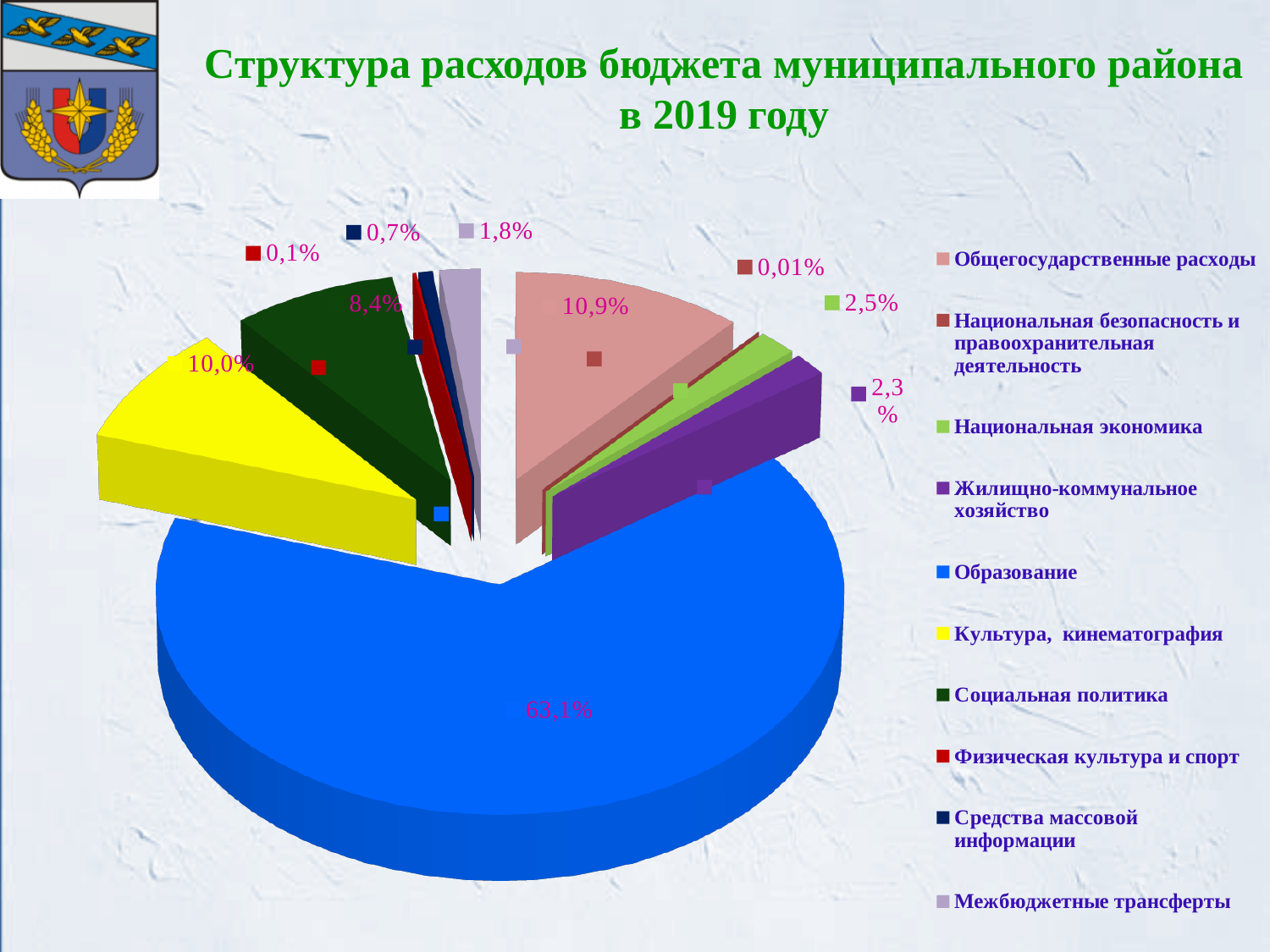
What is the value shown for Культура, кинематография? 10,0% What type of chart is shown on the slide? Pie chart Which category has the largest share of the pie? Образование Which is larger: the share for Средства массовой информации or the share for Физическая культура и спорт? Средства массовой информации Which category has the smallest share of the pie? Национальная безопасность и правоохранительная деятельность What is the value shown for Социальная политика? 8,4% What is the value shown for Национальная безопасность и правоохранительная деятельность? 0,01% What share of the pie does Образование account for? 63,1% What is the value shown for Межбюджетные трансферты? 1,8% What is the value shown for Общегосударственные расходы? 10,9% How many categories does the legend list? 10 What is the difference between the shares of Национальная экономика and Жилищно-коммунальное хозяйство? 0,2%